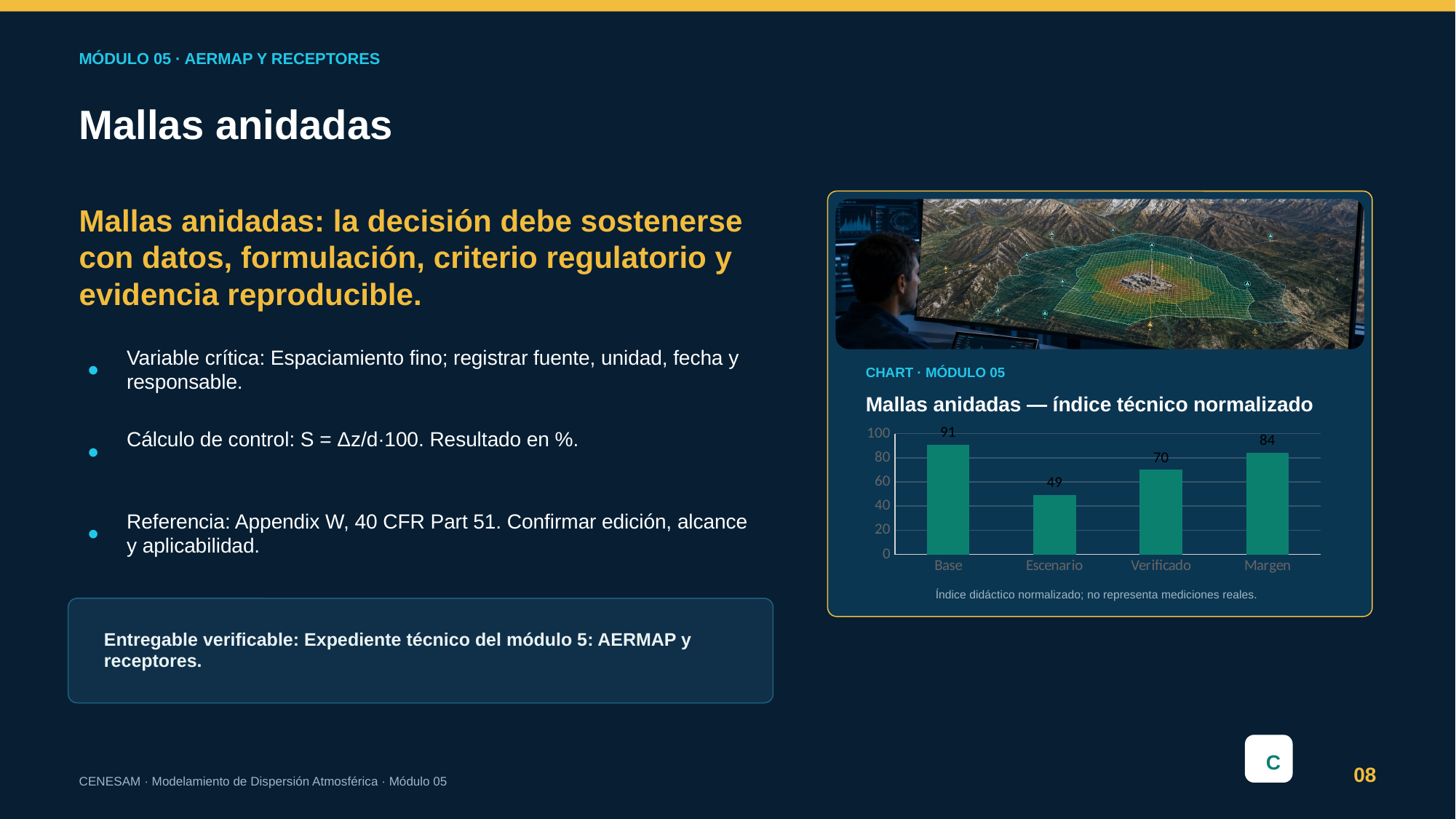
What is the title of the chart? Mallas anidadas — índice técnico normalizado What is the value for Escenario? 49 What is the value for Base? 91 How many categories are shown on the x axis? 4 Which category has the lowest value? Escenario What is the difference between the values for Base and Escenario? 42 What is the value for Margen? 84 Is the value for Escenario greater or less than 60? less Which category has the highest value? Base What is the value for Verificado? 70 What kind of chart is shown? bar chart Which is larger, the value for Verificado or the value for Margen? Margen